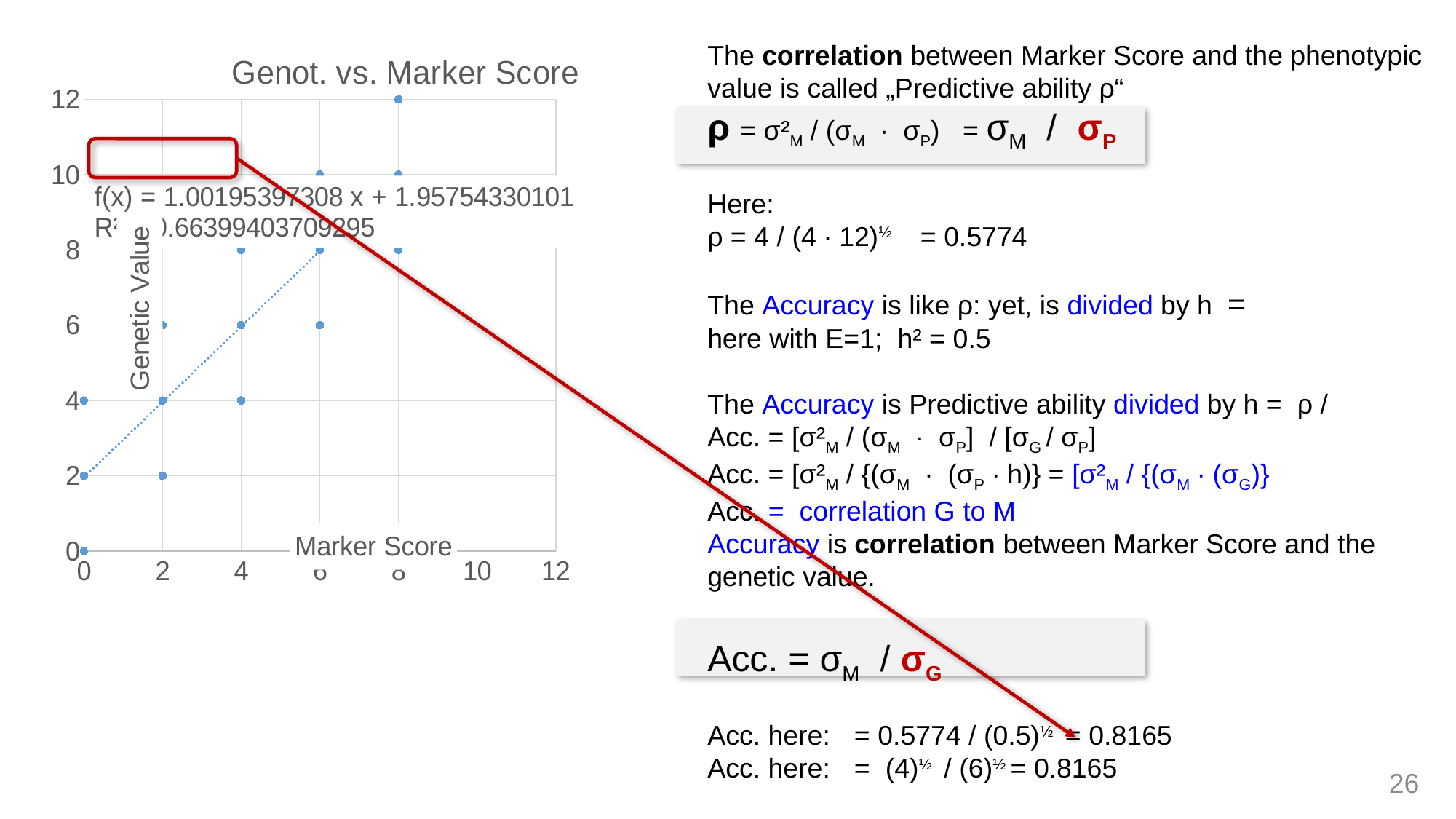
What is the maximum value shown on the y axis of the chart? 12 Do the plotted genetic values generally rise or fall as the marker score increases? rise What is the label of the x axis of the chart? Marker Score What is the highest genetic value plotted at a marker score of 4? 8 What is the slope of the fitted trendline shown in the chart's equation? 1.00195397308 What kind of chart is shown on the slide? scatter chart At which marker score does the highest genetic value (12) occur? 8 What is the lowest genetic value plotted on the chart? 0 What is the title of the chart? Genot. vs. Marker Score What is the highest genetic value plotted on the chart? 12 What is the intercept of the fitted trendline shown in the chart's equation? 1.95754330101